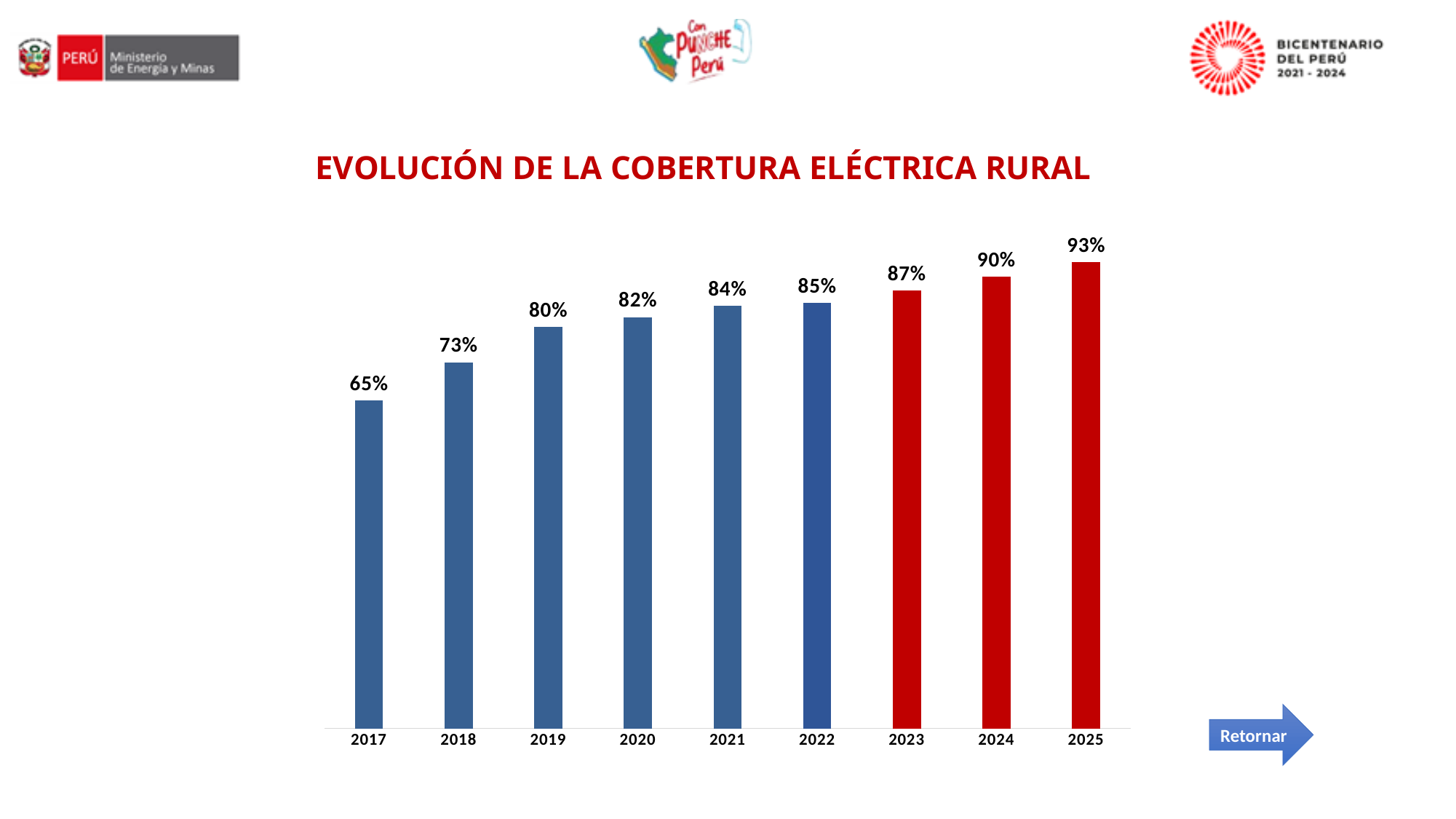
Which year has the lowest value? 2017 How many years are shown on the x axis? 9 What value is shown for 2024? 90% What value is shown for 2022? 85% Which year has the highest value? 2025 What is the difference between the values for 2019 and 2018? 7% Which is larger, the value for 2020 or the value for 2023? 2023 What kind of chart is shown on the slide? Bar chart What is the title of the chart? EVOLUCIÓN DE LA COBERTURA ELÉCTRICA RURAL Do the values rise or fall from 2017 to 2025? Rise What is the rural electrical coverage value shown for 2017? 65% What is the difference between the values for 2025 and 2017? 28%